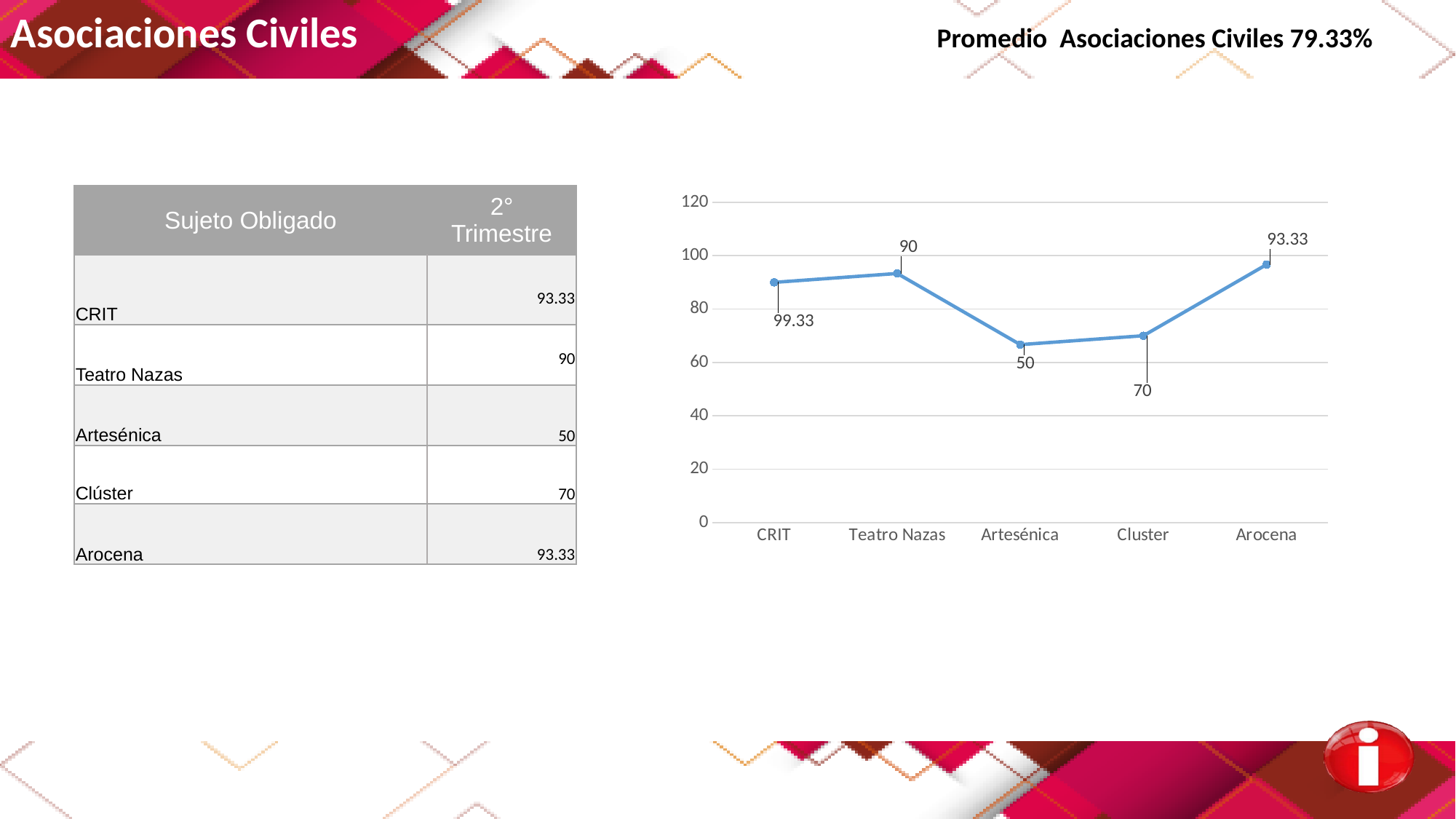
What kind of chart is shown on the slide? line chart Is the value for Arocena greater or less than 80? greater What is the data label value for Cluster in the chart? 70 How many categories are plotted along the x axis of the chart? 5 Does the line rise or fall from Teatro Nazas to Artesénica? fall What is the difference between the data label values for Teatro Nazas and Cluster? 20 Which is larger in the chart, the value for Teatro Nazas or the value for Cluster? Teatro Nazas Which category has the lowest value in the chart? Artesénica What is the highest tick value shown on the chart's vertical axis? 120 What is the data label value for Arocena in the chart? 93.33 What is the data label value for Teatro Nazas in the chart? 90 Is the value for Cluster greater or less than 80? less